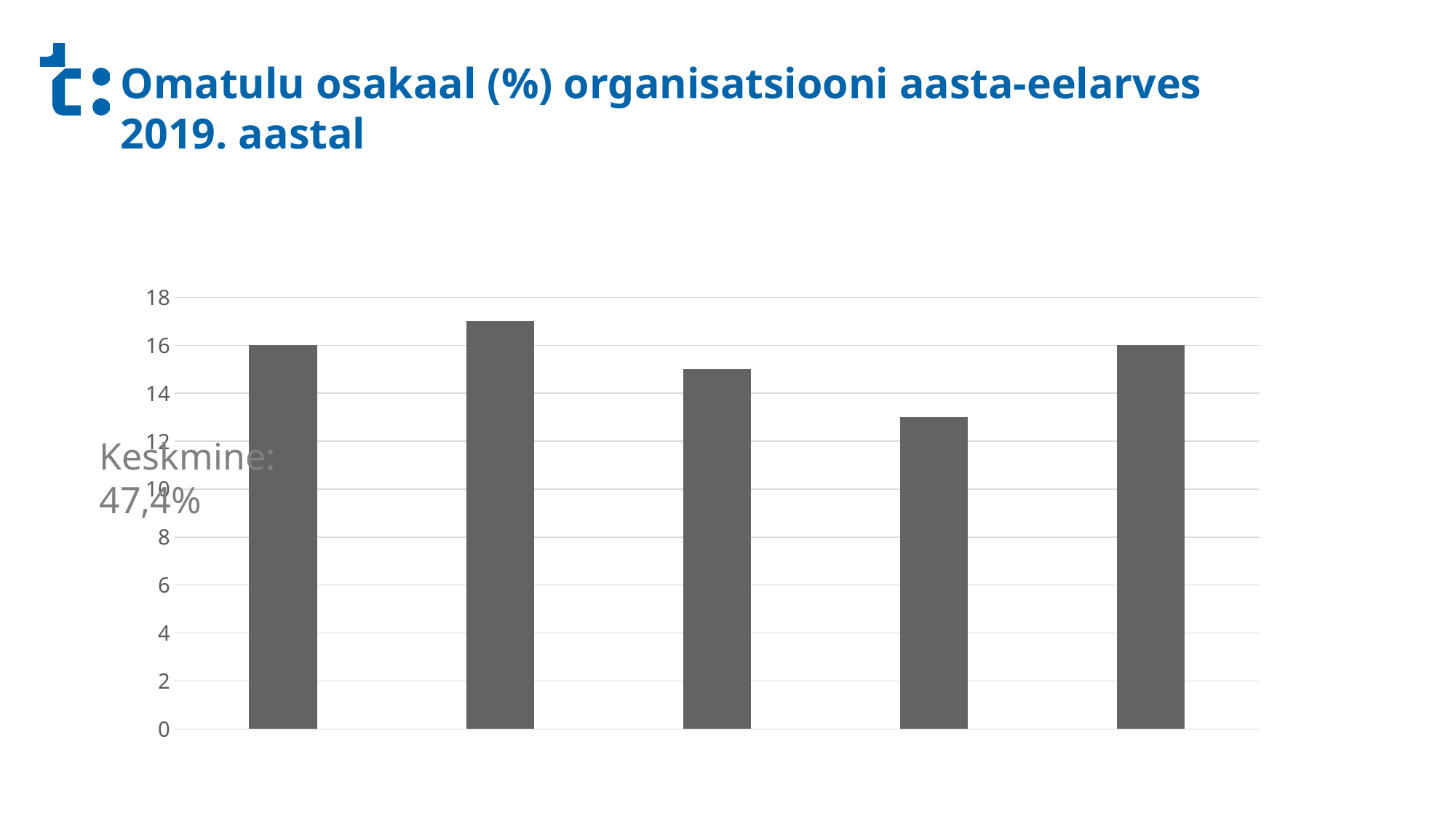
What is the value of the fifth (rightmost) bar? 16 What is the title of the slide? Omatulu osakaal (%) organisatsiooni aasta-eelarves 2019. aastal Which bar is the tallest? the second bar What kind of chart is shown on the slide? bar chart Is the value of the third bar greater or less than 14? greater How many bars are plotted in the chart? 5 Which is larger, the third bar or the fourth bar? the third bar Which bar is the shortest? the fourth bar Is the value of the second bar greater or less than 16? greater Is the value of the fourth bar greater or less than 14? less What average value (Keskmine) is printed on the chart? 47,4% What is the value of the first (leftmost) bar? 16